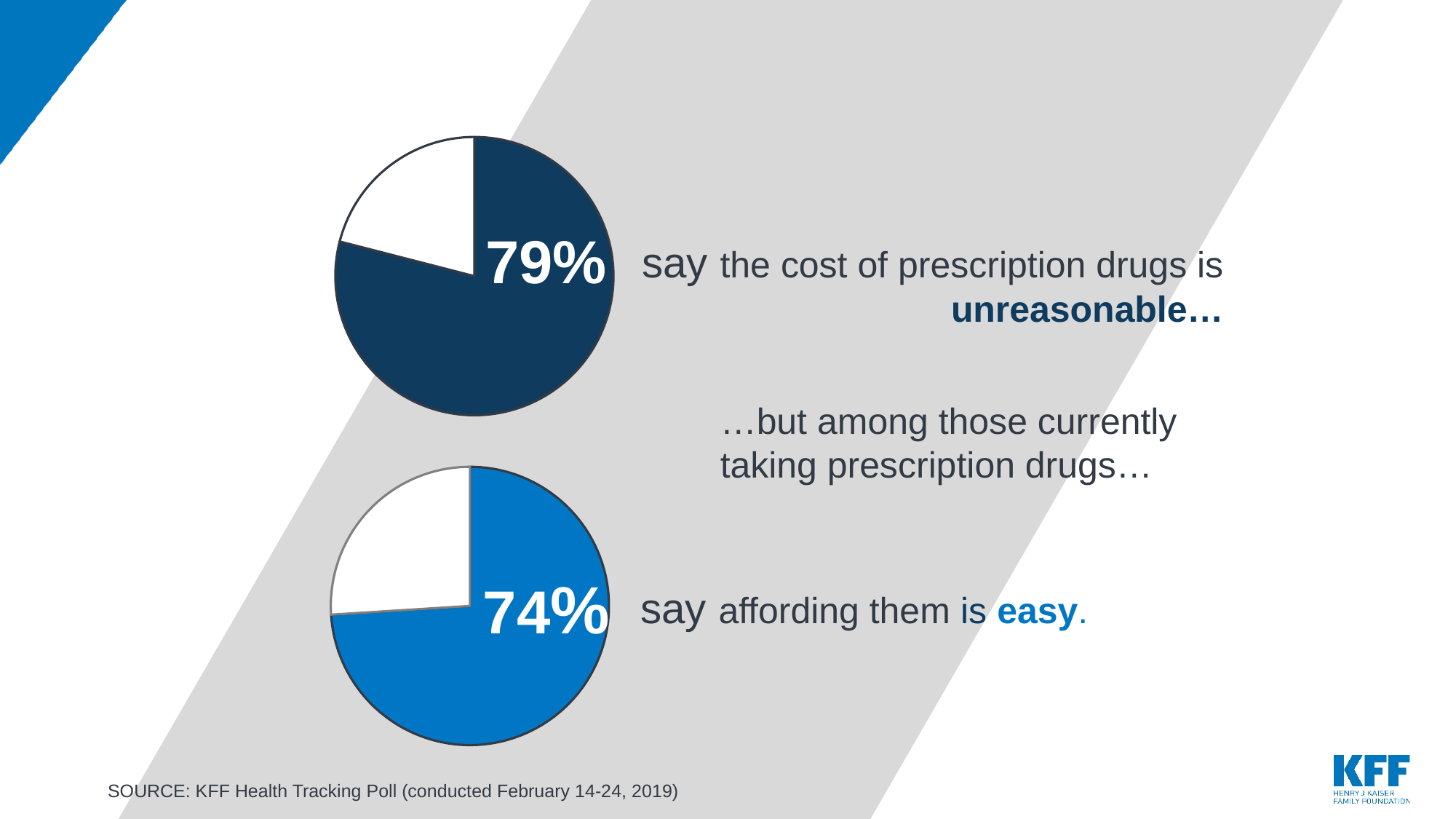
What kind of chart is used for the top chart on the slide? Pie chart How many pie charts are shown on the slide? 2 According to the source note, which poll is the data on the slide from? KFF Health Tracking Poll (conducted February 14-24, 2019) In the bottom pie chart, what percentage of those currently taking prescription drugs say affording them is easy? 74% Which is larger: the labelled share in the top pie chart (unreasonable cost) or the labelled share in the bottom pie chart (affording is easy)? The top pie chart (79%) What kind of chart is used for the bottom chart on the slide? Pie chart What colour is the labelled slice in the bottom pie chart? Blue In the top pie chart, what share of the pie is shaded dark blue? 79% In the top pie chart, what percentage say the cost of prescription drugs is unreasonable? 79% What is the difference in percentage points between the 79% in the top pie chart and the 74% in the bottom pie chart? 5 percentage points In the bottom pie chart, what share of the pie is shaded blue? 74%